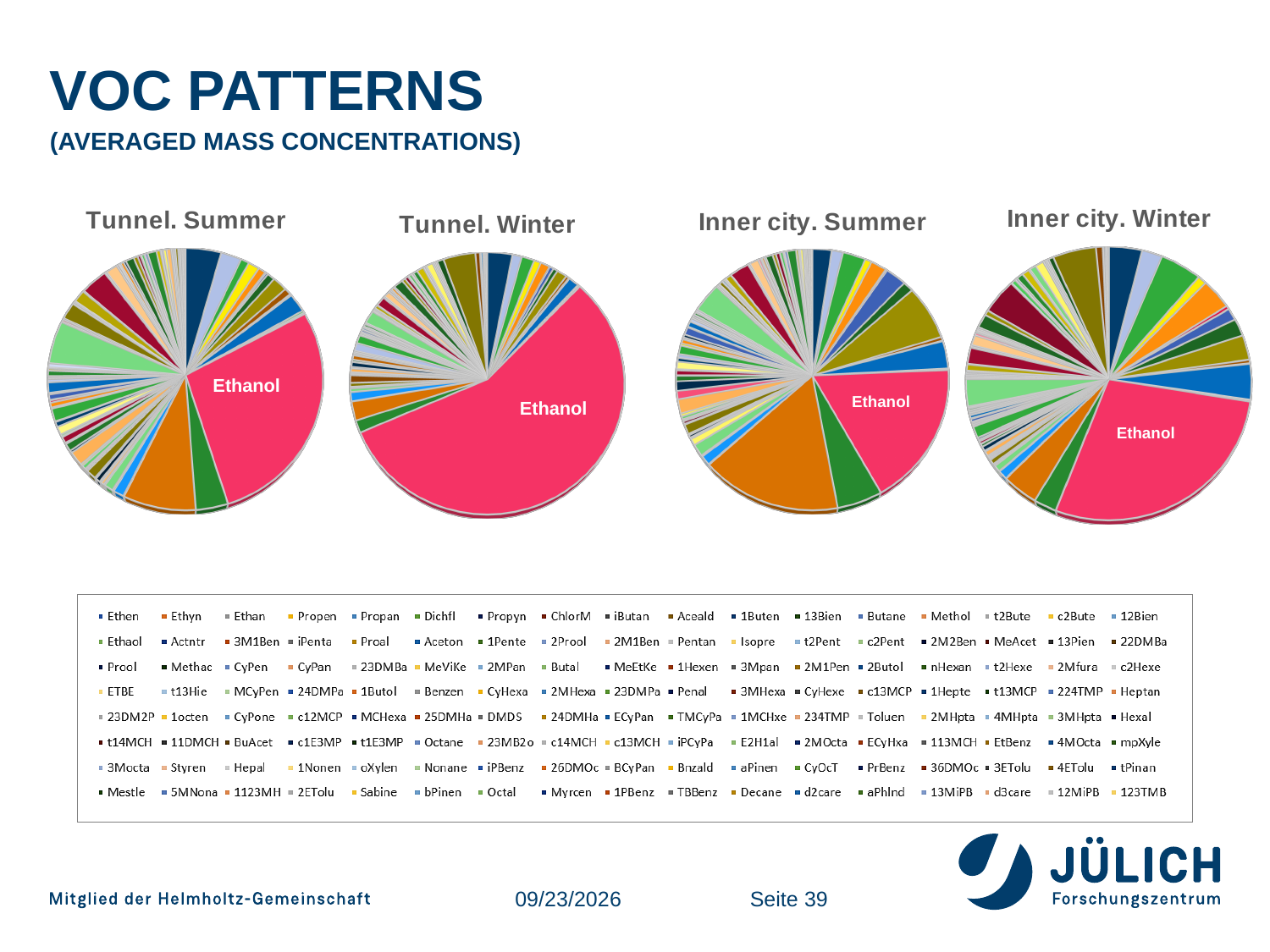
What kind of chart is used for the Tunnel. Summer data? Pie chart Which pie chart shows the larger share for Ethanol, Tunnel. Summer or Tunnel. Winter? Tunnel. Winter In the Inner city. Summer pie chart, which compound has the largest slice? Ethanol Which pie chart shows the larger share for Ethanol, Inner city. Summer or Inner city. Winter? Inner city. Winter Which compound is labelled directly on all four pie charts? Ethanol How many pie charts are shown on the slide? 4 In the Tunnel. Summer pie chart, which compound has the largest slice? Ethanol In the Tunnel. Winter pie chart, which compound has the largest slice? Ethanol What are the titles of the four pie charts on the slide? Tunnel. Summer, Tunnel. Winter, Inner city. Summer, Inner city. Winter